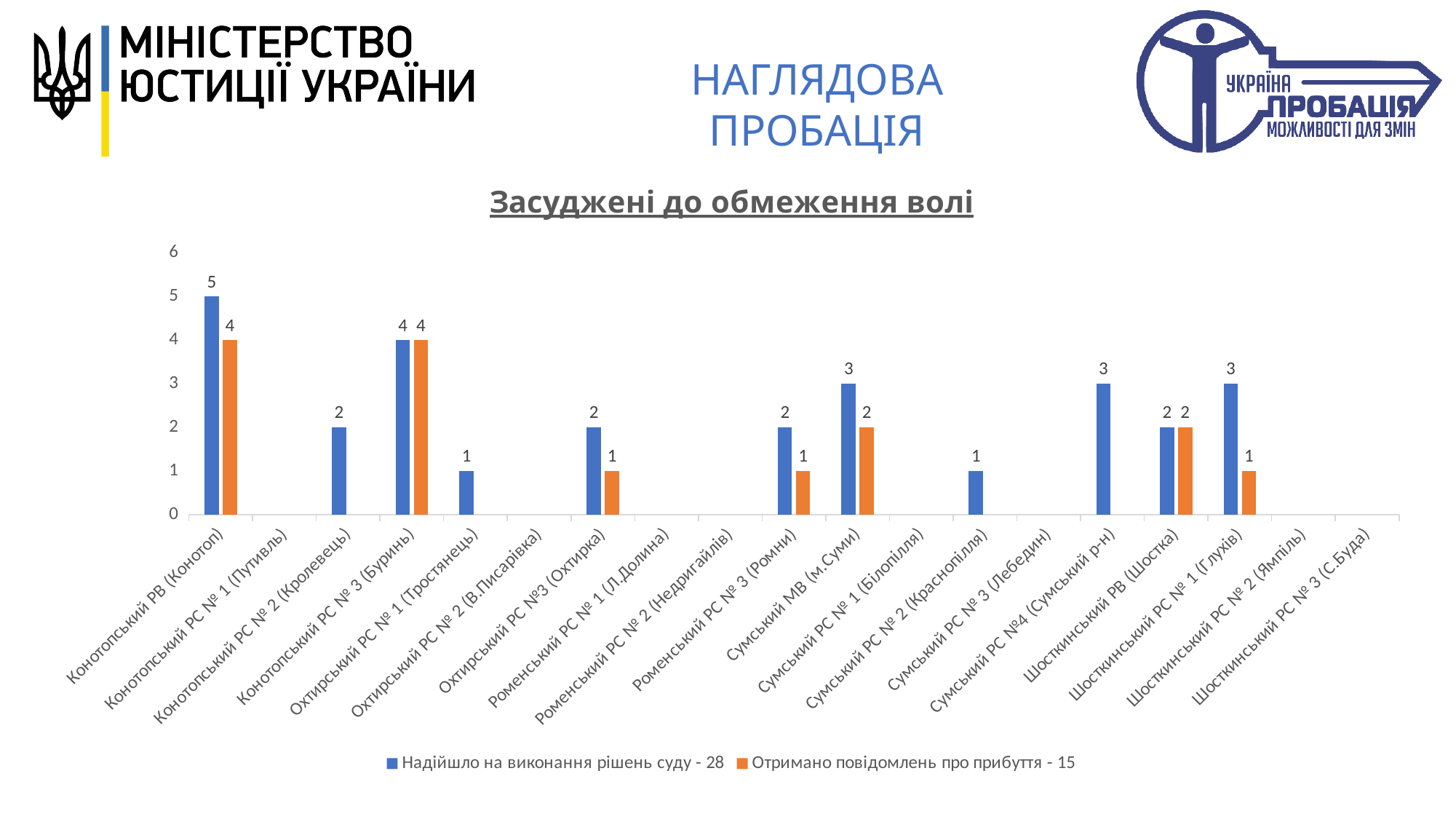
What is the title of the chart? Засуджені до обмеження волі What is the difference between the two series for Конотопський РВ (Конотоп)? 1 What is the value of 'Отримано повідомлень про прибуття' for Шосткинський РС № 1 (Глухів)? 1 What kind of chart is shown on the slide? Bar chart How many categories are shown on the x axis? 19 What total is given in the legend for the series 'Отримано повідомлень про прибуття'? 15 What is the value of 'Отримано повідомлень про прибуття' for Сумський МВ (м.Суми)? 2 What is the difference between 'Надійшло на виконання рішень суду' for Сумський МВ (м.Суми) and for Роменський РС № 3 (Ромни)? 1 How many series does the legend list? 2 Which category has the highest value for 'Надійшло на виконання рішень суду'? Конотопський РВ (Конотоп) Which is larger: 'Надійшло на виконання рішень суду' for Сумський РС №4 (Сумський р-н) or for Конотопський РС № 2 (Кролевець)? Сумський РС №4 (Сумський р-н) What is the value of 'Надійшло на виконання рішень суду' for Конотопський РВ (Конотоп)? 5